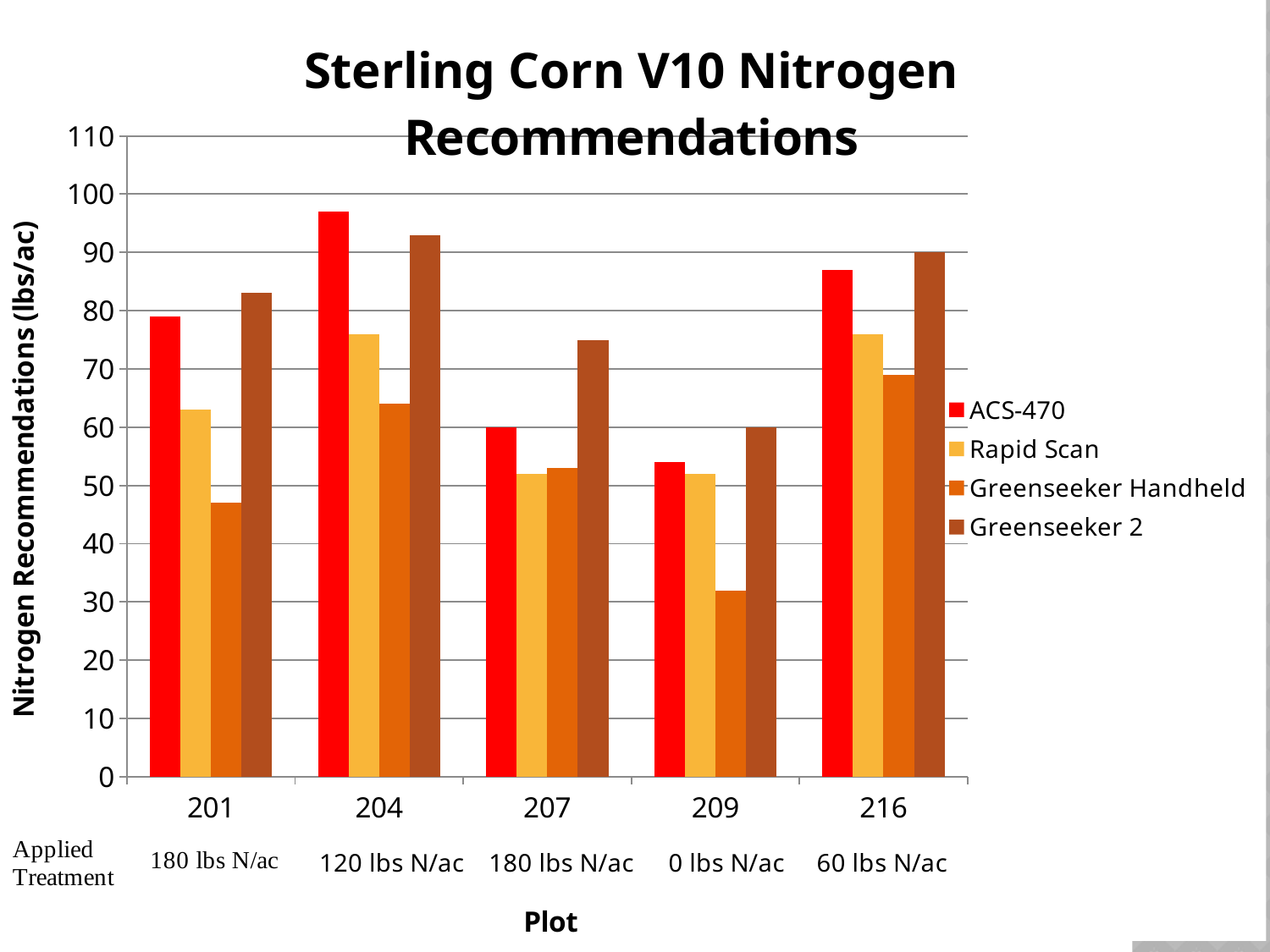
For plot 201, which is larger: the ACS-470 value or the Greenseeker 2 value? Greenseeker 2 Is the Greenseeker 2 value for plot 201 greater or less than 80? greater For which plot is the ACS-470 recommendation highest? 204 What kind of chart is shown on the slide? bar chart How many plots are shown on the x axis? 5 How many series does the legend list? 4 For plot 209, which is larger: the Rapid Scan value or the Greenseeker Handheld value? Rapid Scan Is the Greenseeker Handheld value for plot 209 greater or less than 40? less For which plot is the Greenseeker Handheld recommendation lowest? 209 What is the title of the x axis? Plot Is the Greenseeker Handheld value for plot 201 greater or less than 50? less